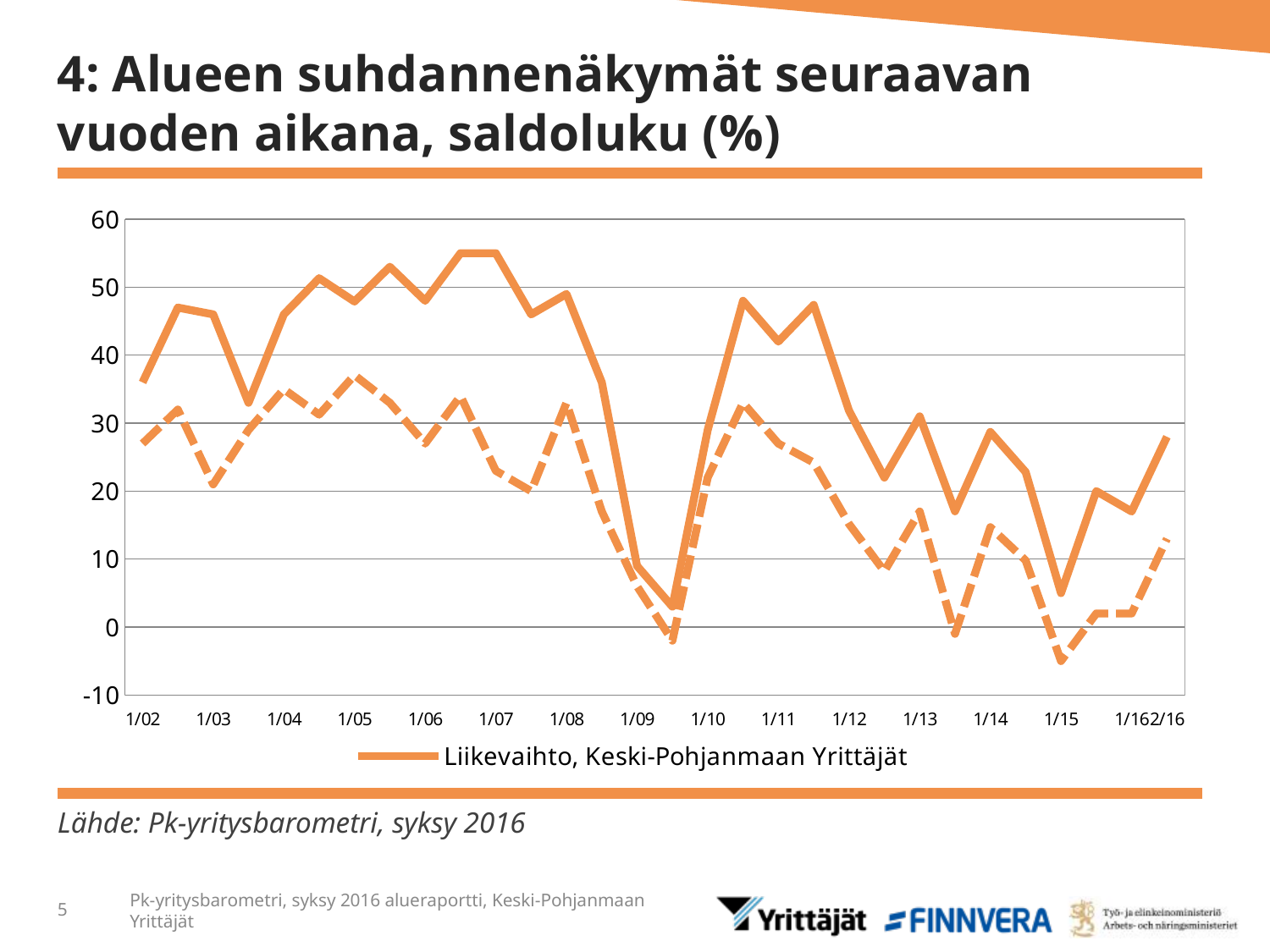
Is the value of the solid line at 1/15 greater or less than 10? less What is the title of the slide containing the chart? 4: Alueen suhdannenäkymät seuraavan vuoden aikana, saldoluku (%) How many series does the legend list? 1 Is the value of the solid line at 1/07 greater or less than 50? greater Is the value of the solid line at 1/02 greater or less than 30? greater What is the legend entry shown below the chart? Liikevaihto, Keski-Pohjanmaan Yrittäjät Does the solid line rise or fall between 1/07 and 1/09? fall Which line is higher at 1/05, the solid line or the dashed line? the solid line What kind of chart is shown on the slide? line chart